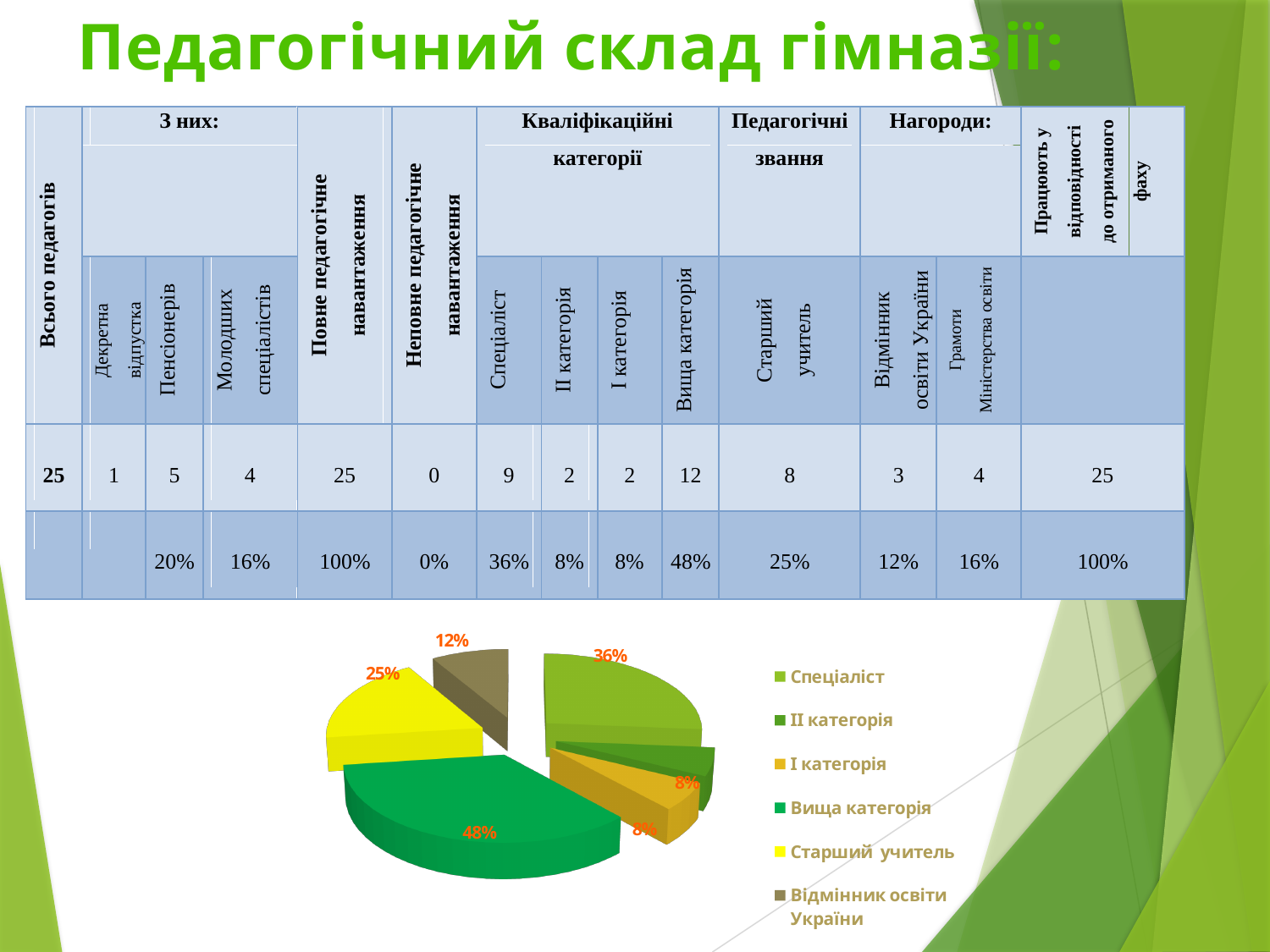
What kind of chart is shown at the bottom of the slide? pie chart In the pie chart, what is the value shown for Вища категорія? 48% In the pie chart, what is the value shown for Відмінник освіти України? 12% In the pie chart, what is the value shown for II категорія? 8% In the pie chart, what is the value shown for Спеціаліст? 36% In the pie chart, what is the difference between the values for Вища категорія and Спеціаліст? 12% In the pie chart, what is the difference between the values for Старший учитель and Відмінник освіти України? 13% Which slice of the pie chart is larger: Спеціаліст or Старший учитель? Спеціаліст Which slice of the pie chart is the largest? Вища категорія How many entries does the legend of the pie chart list? 6 Which legend entry of the pie chart is shown in yellow? Старший учитель In the pie chart, what is the value shown for Старший учитель? 25%